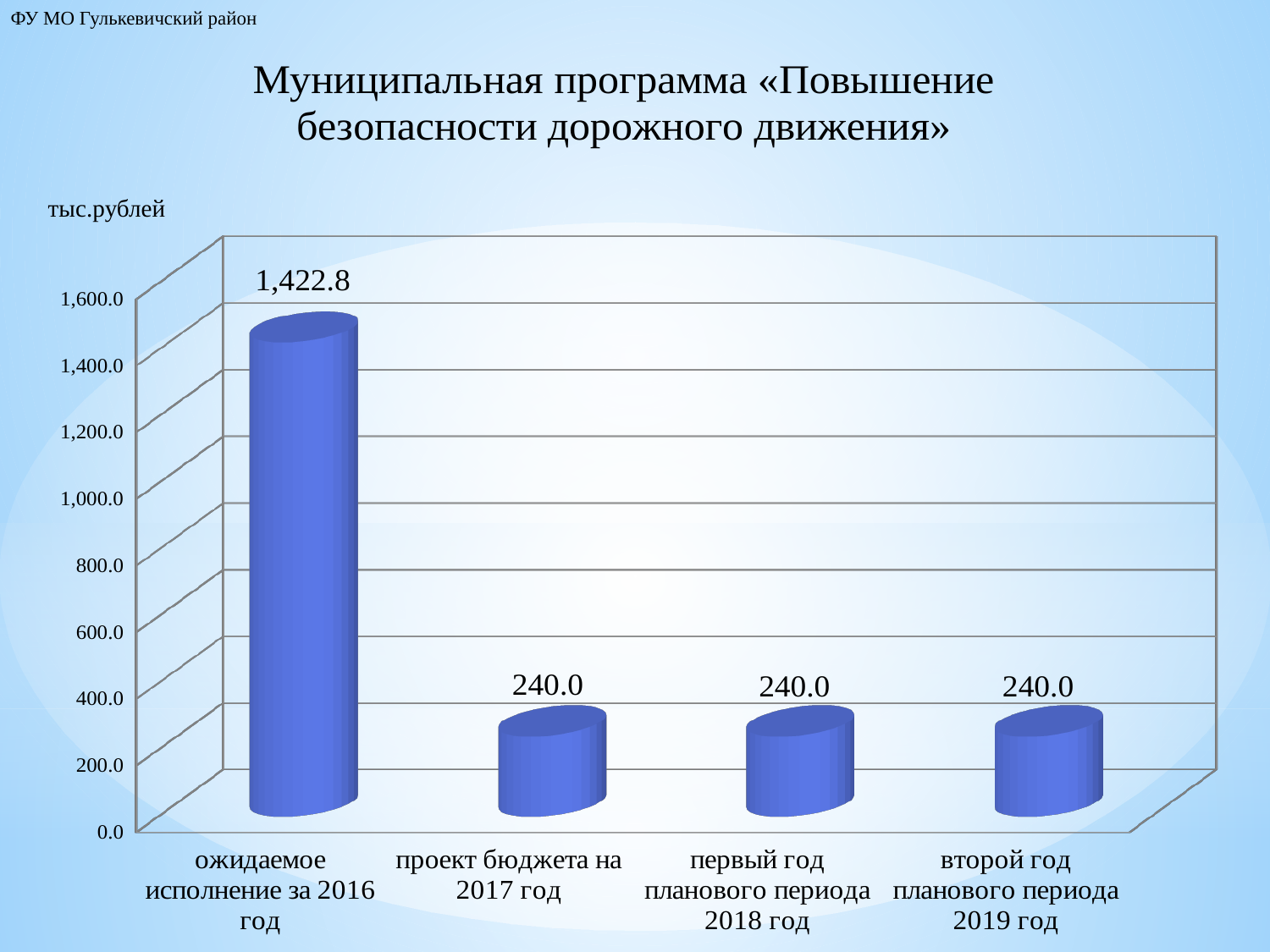
What is the difference between the value for «ожидаемое исполнение за 2016 год» and the value for «проект бюджета на 2017 год»? 1,182.8 Which is larger: the value for «ожидаемое исполнение за 2016 год» or the value for «второй год планового периода 2019 год»? ожидаемое исполнение за 2016 год Which category has the highest value? ожидаемое исполнение за 2016 год What unit is indicated above the chart? тыс.рублей Is the value for «проект бюджета на 2017 год» greater or less than 400.0? less What is the value for «первый год планового периода 2018 год»? 240.0 Do the values rise or fall from the first category to the second category along the x axis? fall What kind of chart is shown on the slide? bar chart What is the value for «ожидаемое исполнение за 2016 год»? 1,422.8 What is the value for «проект бюджета на 2017 год»? 240.0 How many categories are shown on the x axis? 4 What is the value for «второй год планового периода 2019 год»? 240.0